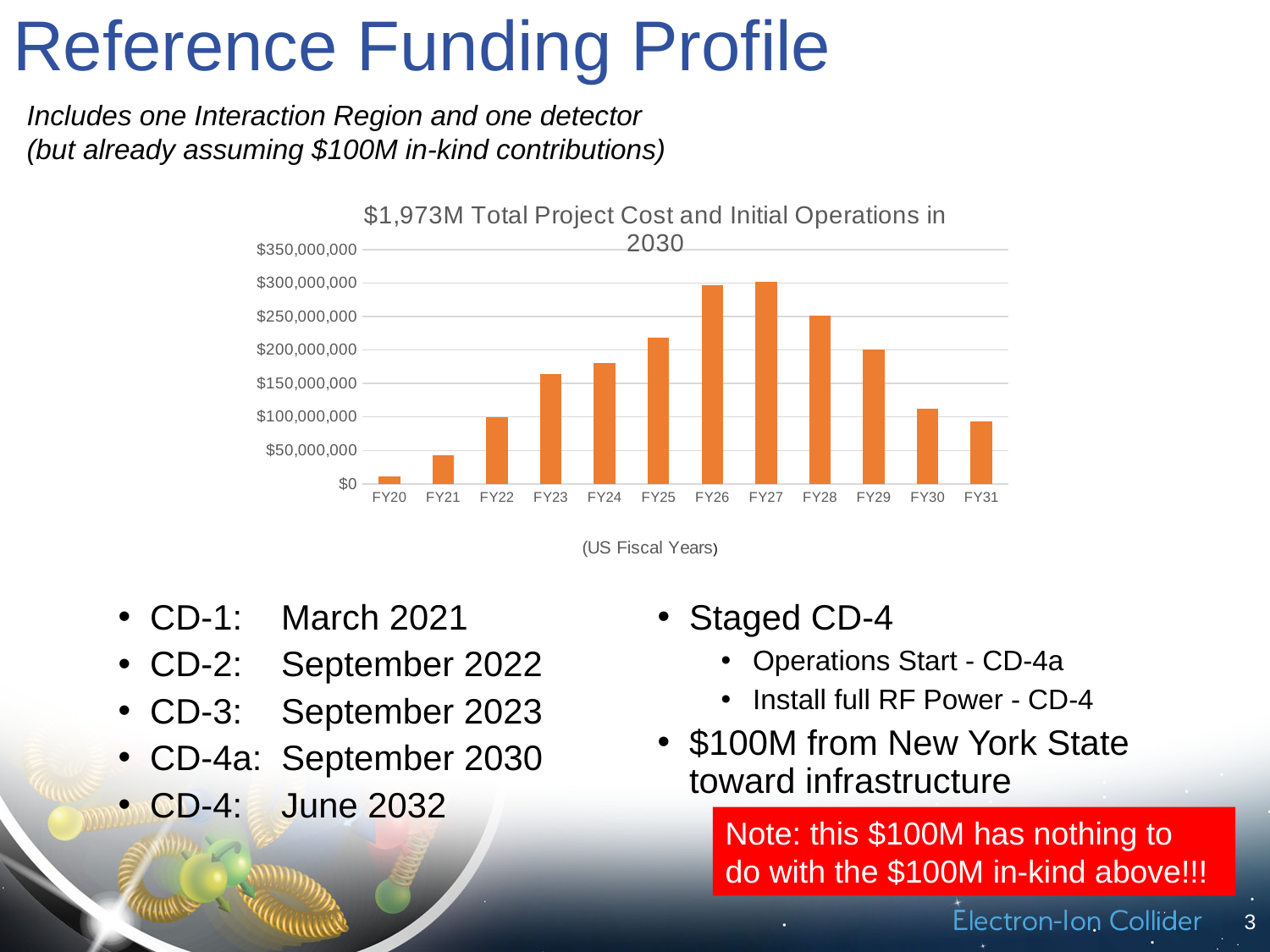
Is the value for FY25 greater or less than $200,000,000? greater Which is larger, the value for FY24 or the value for FY30? FY24 Is the value for FY31 greater or less than $100,000,000? less What is the title of the chart? $1,973M Total Project Cost and Initial Operations in 2030 What kind of chart is shown on the slide? bar chart Which fiscal year has the lowest value on the chart? FY20 Which is larger, the value for FY23 or the value for FY31? FY23 Do the values rise or fall from FY20 to FY26? rise Is the value for FY26 greater or less than $250,000,000? greater How many fiscal years are plotted on the chart? 12